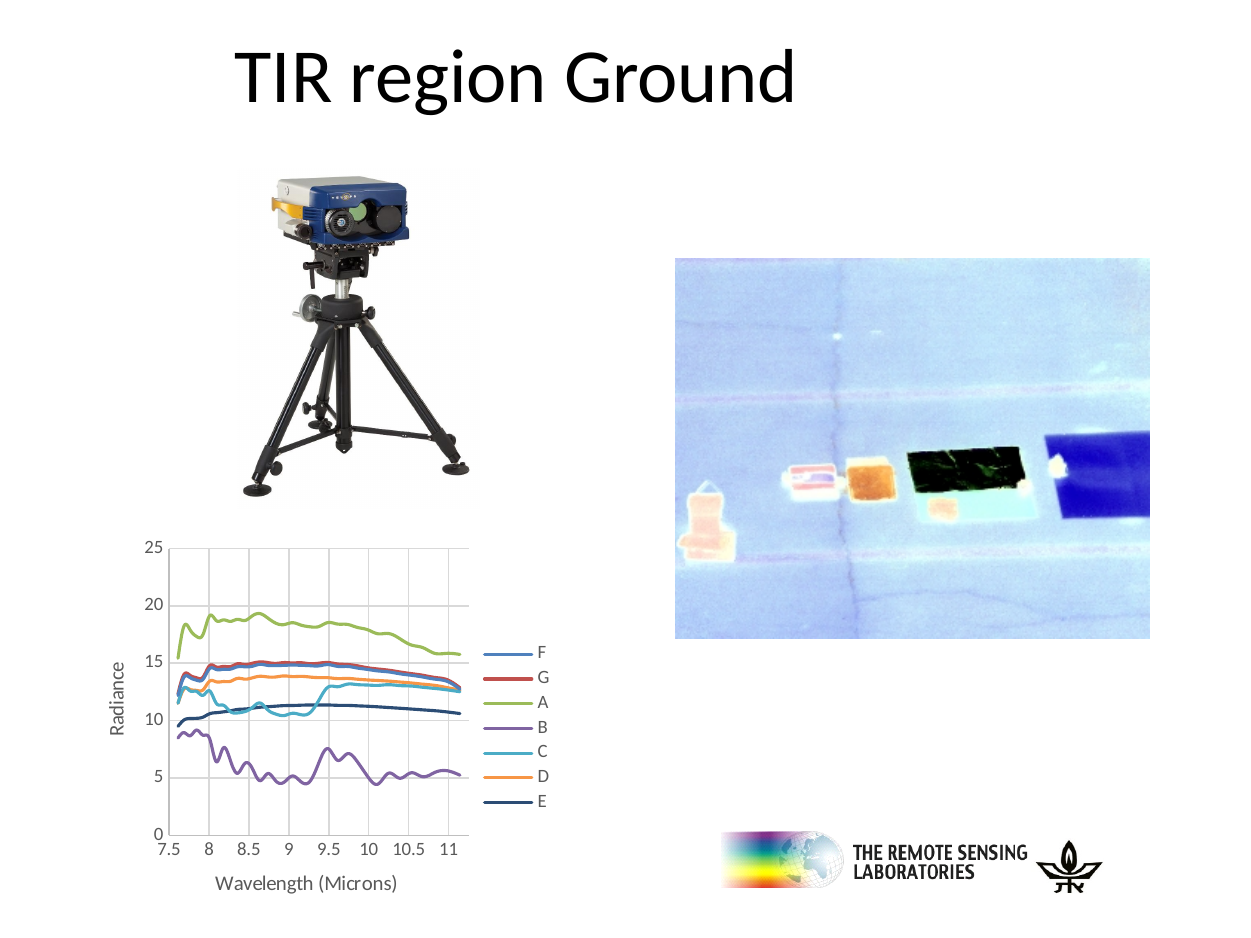
What is the label of the x axis of the chart? Wavelength (Microns) Is the radiance of series A at 11 microns greater or less than 10? greater Does the radiance of series A rise or fall between 8.5 and 11 microns? fall How many series does the chart's legend list? 7 Is the radiance of series E at 9 microns greater or less than 15? less What is the label of the y axis of the chart? Radiance At 9 microns, which series has the larger radiance, A or B? A Is the radiance of series B at 10 microns greater or less than 10? less Which series has the highest radiance values across the wavelength range? A What kind of chart is shown on the slide? line chart Which series has the lowest radiance values across the wavelength range? B